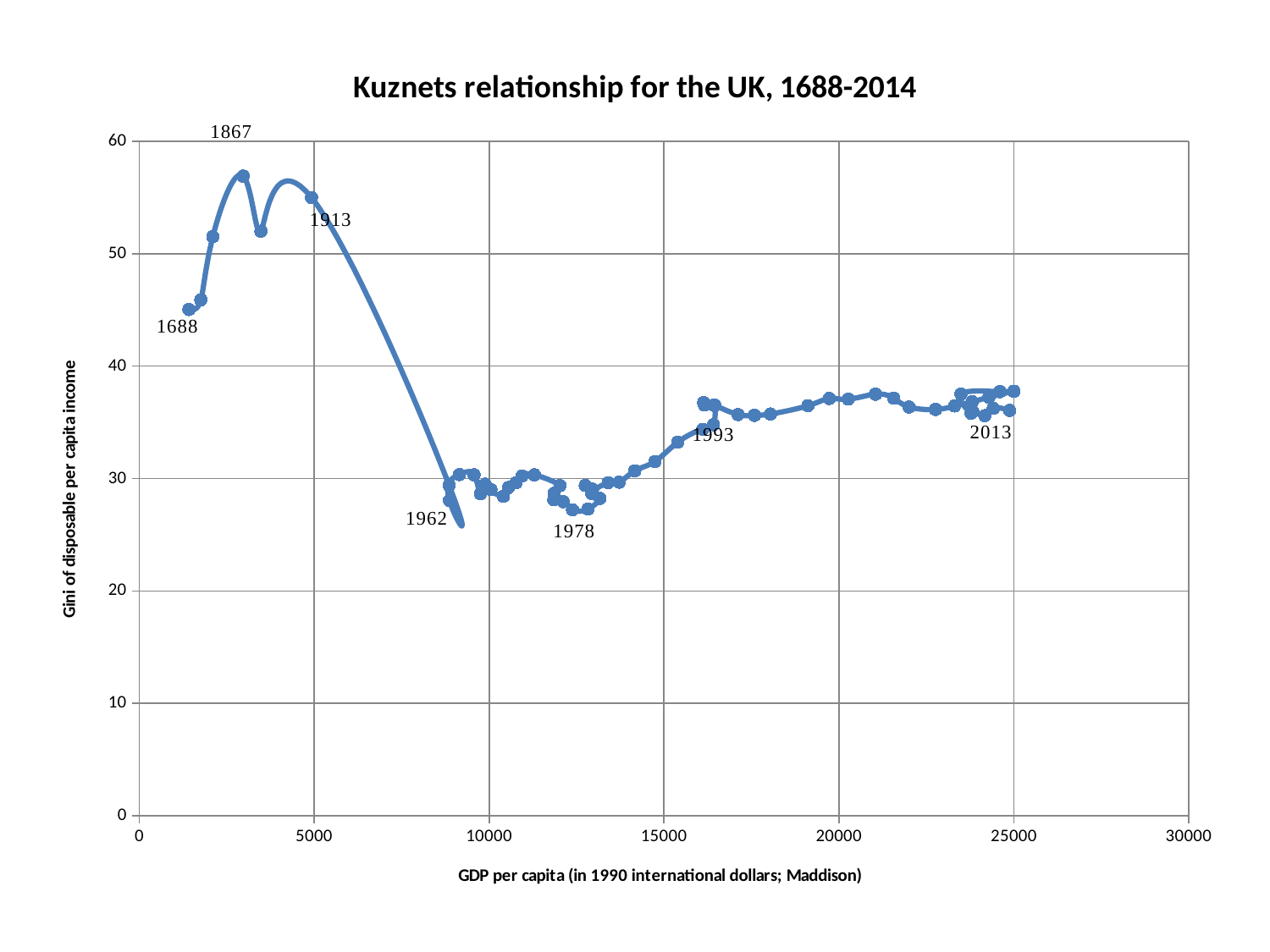
Between the points labelled 1913 and 1962, does the Gini value rise or fall as GDP per capita increases? fall What is the title of the chart? Kuznets relationship for the UK, 1688-2014 Is the Gini value for the point labelled 1978 greater or less than 30? less Which labelled year has the highest Gini value on the chart? 1867 What kind of chart is shown on the slide? line chart Which has the higher Gini value, the point labelled 1688 or the point labelled 1962? 1688 Is the Gini value for the point labelled 1867 greater or less than 50? greater How many data series are plotted on the chart? 1 Which has the higher Gini value, the point labelled 1913 or the point labelled 1993? 1913 Is the Gini value for the point labelled 1688 greater or less than 40? greater What is the label of the horizontal axis? GDP per capita (in 1990 international dollars; Maddison)